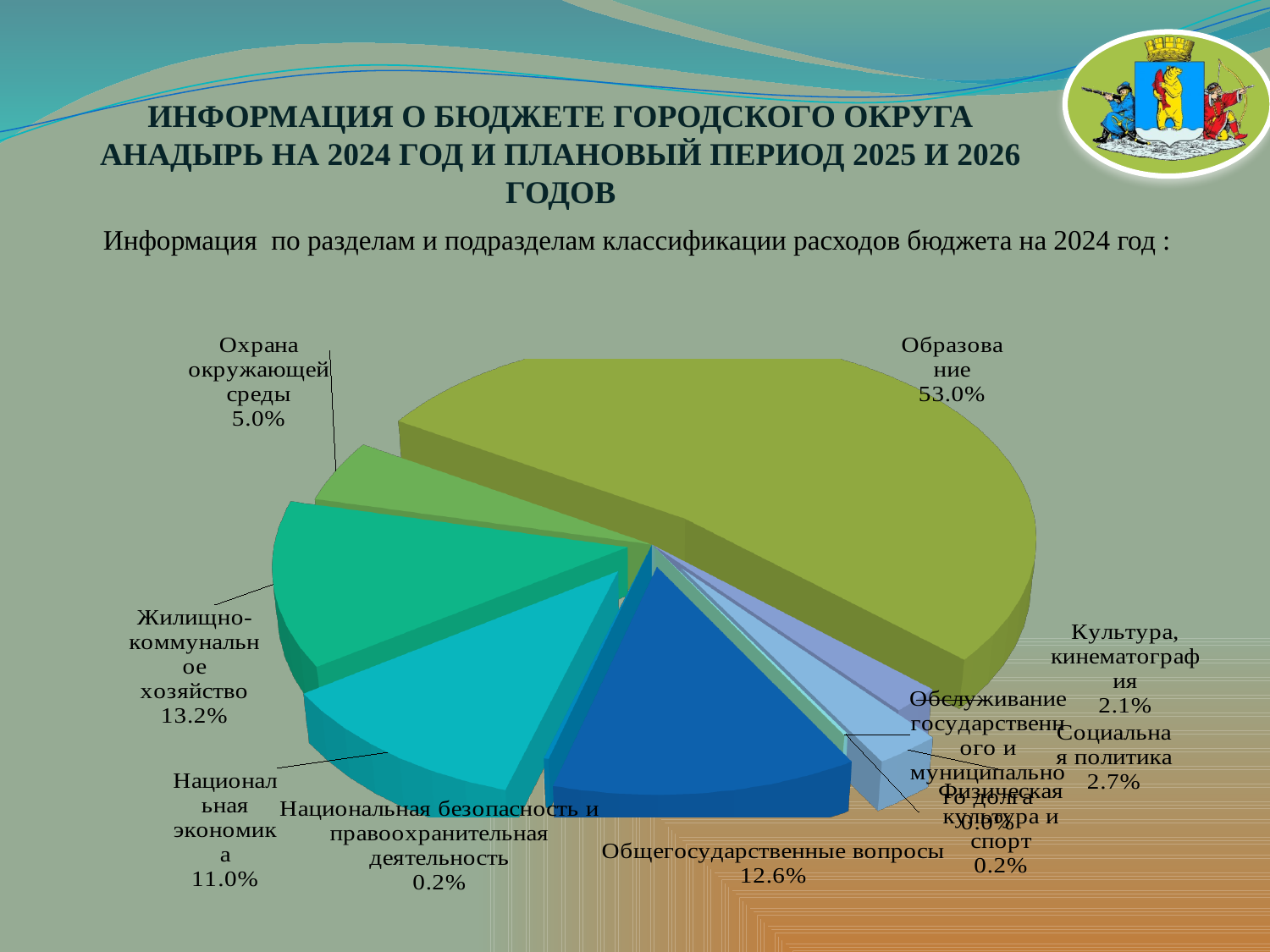
What type of chart is shown on the slide? pie chart What share of expenditures is shown for Жилищно-коммунальное хозяйство? 13.2% What percentage is shown for Культура, кинематография? 2.1% What is the difference between the shares for Образование and Жилищно-коммунальное хозяйство? 39.8% What is the difference between the shares for Национальная экономика and Охрана окружающей среды? 6.0% Which is larger, the share for Жилищно-коммунальное хозяйство or for Общегосударственные вопросы? Жилищно-коммунальное хозяйство Which section has the largest share of the pie? Образование What share of the 2024 budget expenditures goes to Образование? 53.0% What percentage is shown for Социальная политика? 2.7% What percentage is shown for Национальная экономика? 11.0% What share is shown for Охрана окружающей среды? 5.0% What percentage is shown for Общегосударственные вопросы? 12.6%